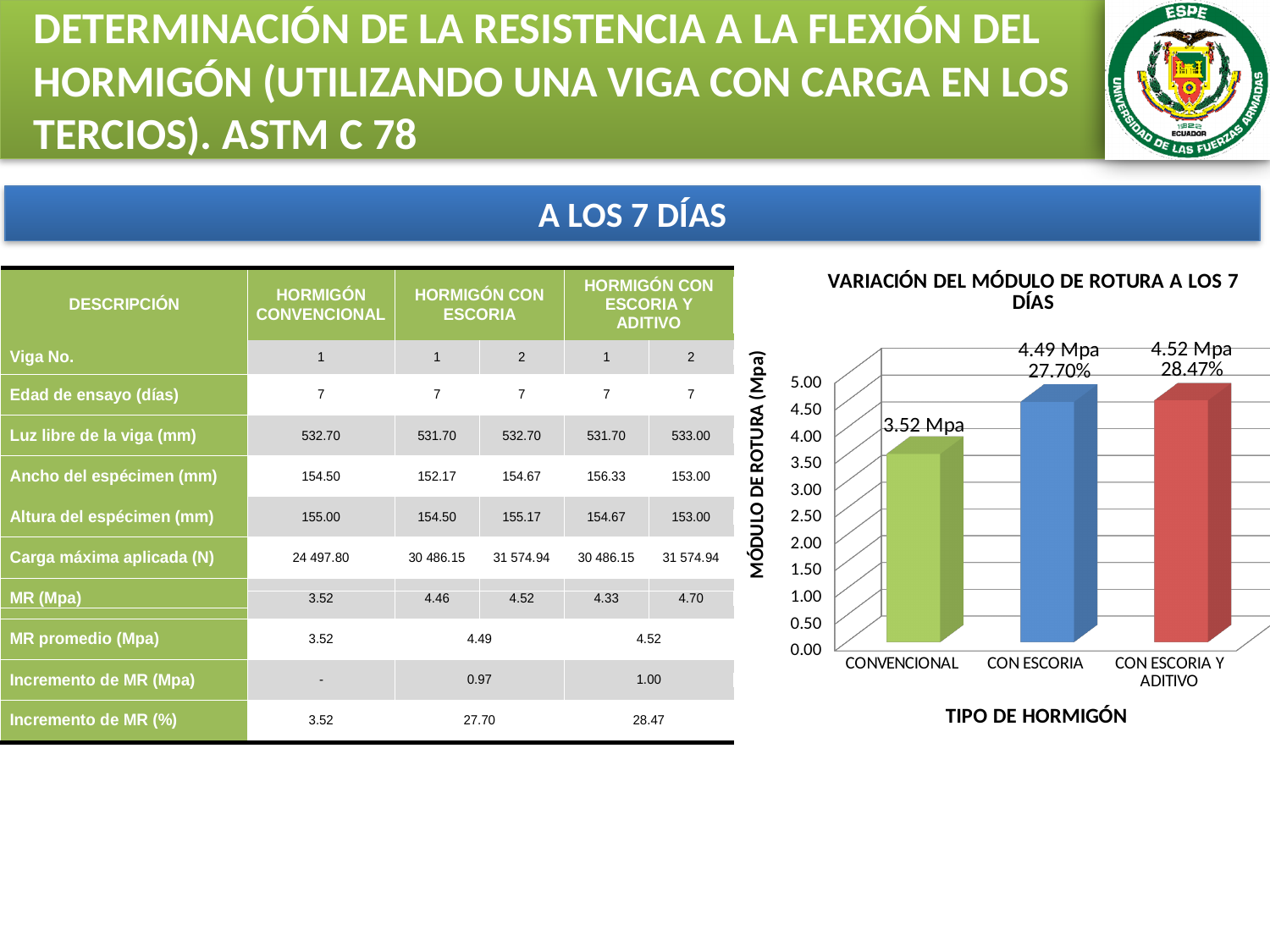
What kind of chart is shown on the slide? Bar chart What percentage is shown above the CON ESCORIA Y ADITIVO bar? 28.47% What is the title of the chart? VARIACIÓN DEL MÓDULO DE ROTURA A LOS 7 DÍAS What is the value for CONVENCIONAL in the chart? 3.52 Mpa What is the value for CON ESCORIA Y ADITIVO in the chart? 4.52 Mpa What is the value for CON ESCORIA in the chart? 4.49 Mpa What percentage is shown above the CON ESCORIA bar? 27.70% Which type of concrete has the lowest módulo de rotura in the chart? CONVENCIONAL Which is larger, the value for CON ESCORIA or the value for CONVENCIONAL? CON ESCORIA How many types of concrete are plotted in the chart? 3 What is the difference between the values for CON ESCORIA Y ADITIVO and CONVENCIONAL? 1.00 Mpa Which type of concrete has the highest módulo de rotura in the chart? CON ESCORIA Y ADITIVO